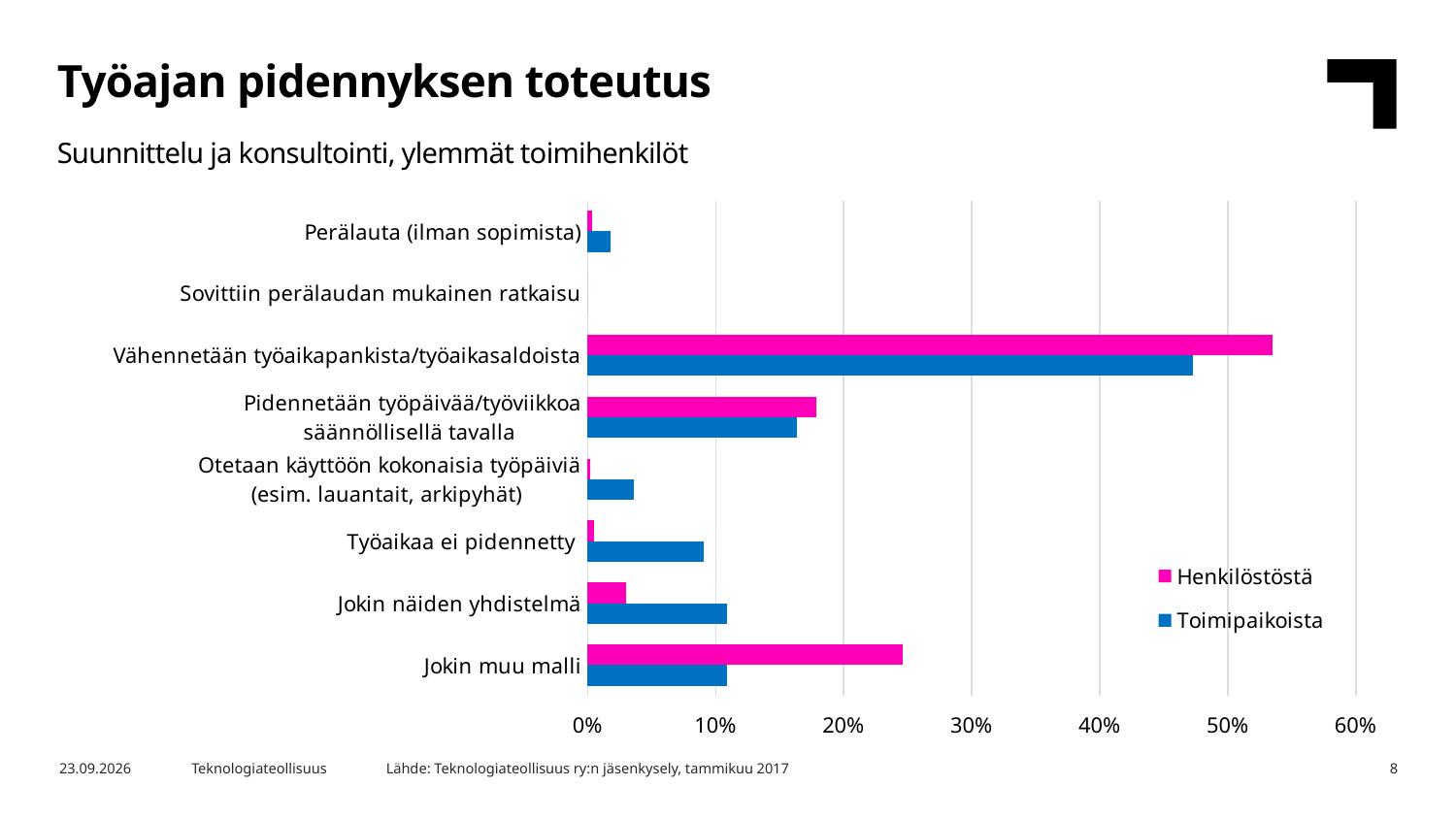
Is the Henkilöstöstä value for Jokin muu malli greater or less than 20%? greater How many series does the legend list? 2 Which category has the highest value for Henkilöstöstä? Vähennetään työaikapankista/työaikasaldoista Which category has the highest value for Toimipaikoista? Vähennetään työaikapankista/työaikasaldoista Is the Henkilöstöstä value for Vähennetään työaikapankista/työaikasaldoista greater or less than 50%? greater How many categories are shown on the chart? 8 Is the Toimipaikoista value for Työaikaa ei pidennetty greater or less than 10%? less Which colour represents the Toimipaikoista series in the chart? blue For Jokin näiden yhdistelmä, which series has the larger value, Henkilöstöstä or Toimipaikoista? Toimipaikoista What kind of chart is shown on the slide? bar chart For Jokin muu malli, which series has the larger value, Henkilöstöstä or Toimipaikoista? Henkilöstöstä